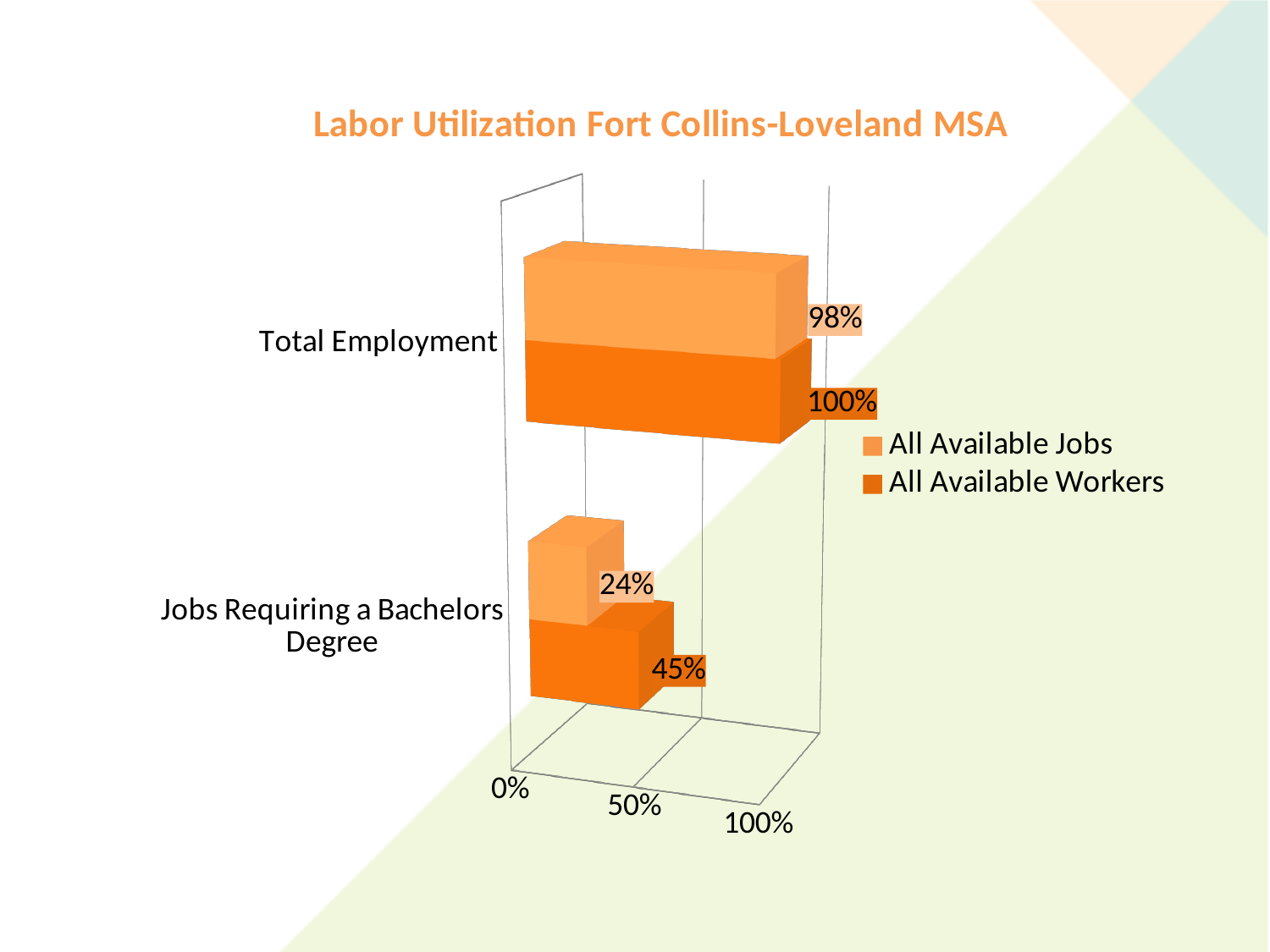
What is the value for All Available Workers in the Jobs Requiring a Bachelors Degree category? 45% How many series does the legend list? 2 How many categories are shown on the chart? 2 What is the value for All Available Jobs in the Total Employment category? 98% What is the value for All Available Jobs in the Jobs Requiring a Bachelors Degree category? 24% What is the difference between All Available Workers and All Available Jobs for Jobs Requiring a Bachelors Degree? 21% What is the title of the chart? Labor Utilization Fort Collins-Loveland MSA What is the value for All Available Workers in the Total Employment category? 100% Which category has the lowest value for All Available Jobs? Jobs Requiring a Bachelors Degree For Jobs Requiring a Bachelors Degree, which series has the larger value: All Available Jobs or All Available Workers? All Available Workers What is the difference between All Available Workers and All Available Jobs for Total Employment? 2% Is the value for All Available Workers in Jobs Requiring a Bachelors Degree greater or less than 50%? less